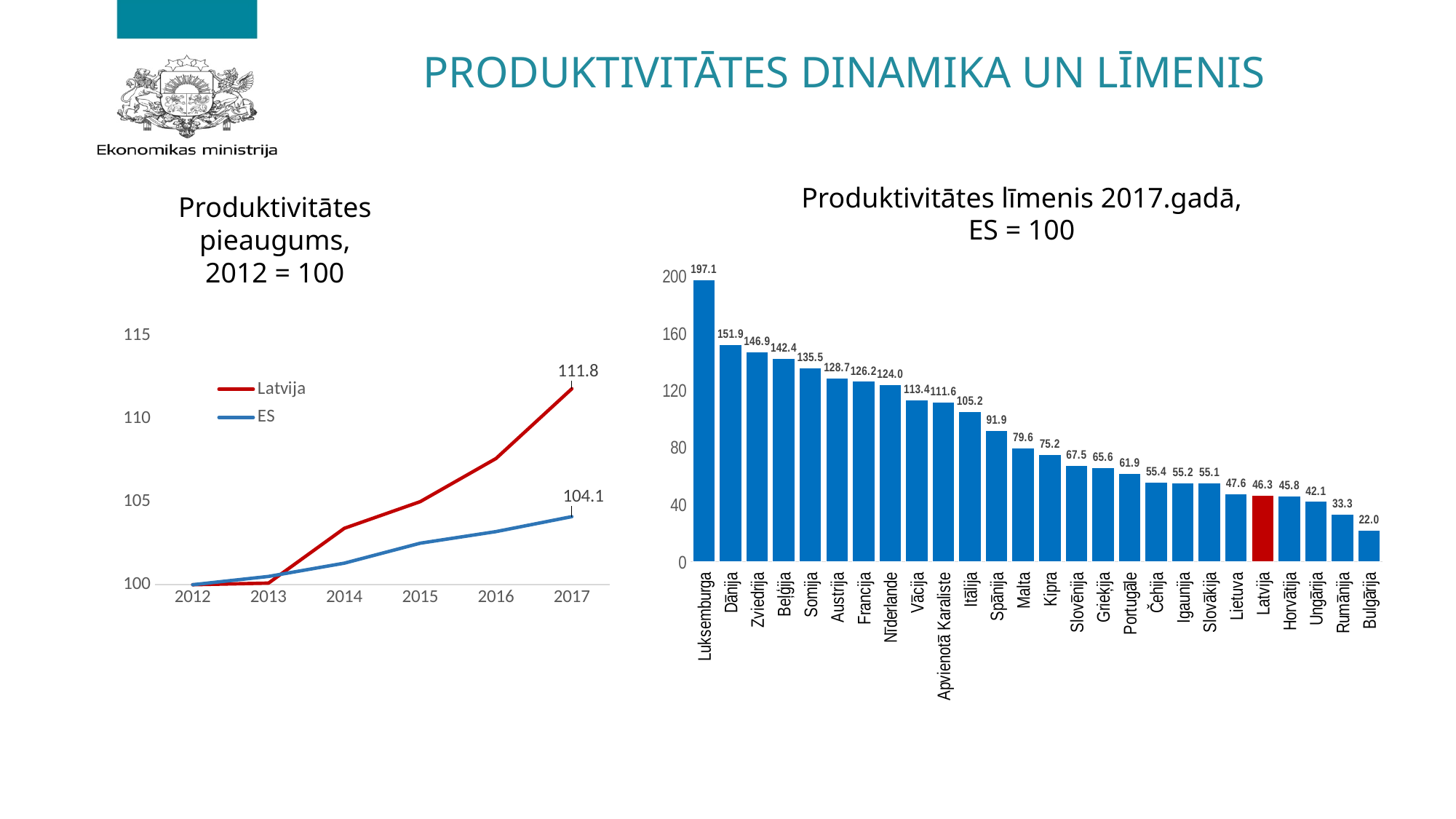
What kind of chart is 'Produktivitātes pieaugums, 2012 = 100'? Line chart In the chart 'Produktivitātes līmenis 2017.gadā, ES = 100', which country has the highest value? Luksemburga In the chart 'Produktivitātes pieaugums, 2012 = 100', what is the value for Latvija in 2017? 111.8 In the chart 'Produktivitātes pieaugums, 2012 = 100', how many series does the legend list? 2 In the chart 'Produktivitātes līmenis 2017.gadā, ES = 100', which country has the lowest value? Bulgārija In the chart 'Produktivitātes līmenis 2017.gadā, ES = 100', what is the value for Vācija? 113.4 In the chart 'Produktivitātes līmenis 2017.gadā, ES = 100', how many countries are shown? 26 In the chart 'Produktivitātes pieaugums, 2012 = 100', what is the value for ES in 2017? 104.1 In the chart 'Produktivitātes līmenis 2017.gadā, ES = 100', which has a higher value, Igaunija or Slovākija? Igaunija In the chart 'Produktivitātes līmenis 2017.gadā, ES = 100', what is the value for Latvija? 46.3 In the chart 'Produktivitātes līmenis 2017.gadā, ES = 100', which bar is coloured red? Latvija In the chart 'Produktivitātes līmenis 2017.gadā, ES = 100', what is the difference between the values for Lietuva and Latvija? 1.3